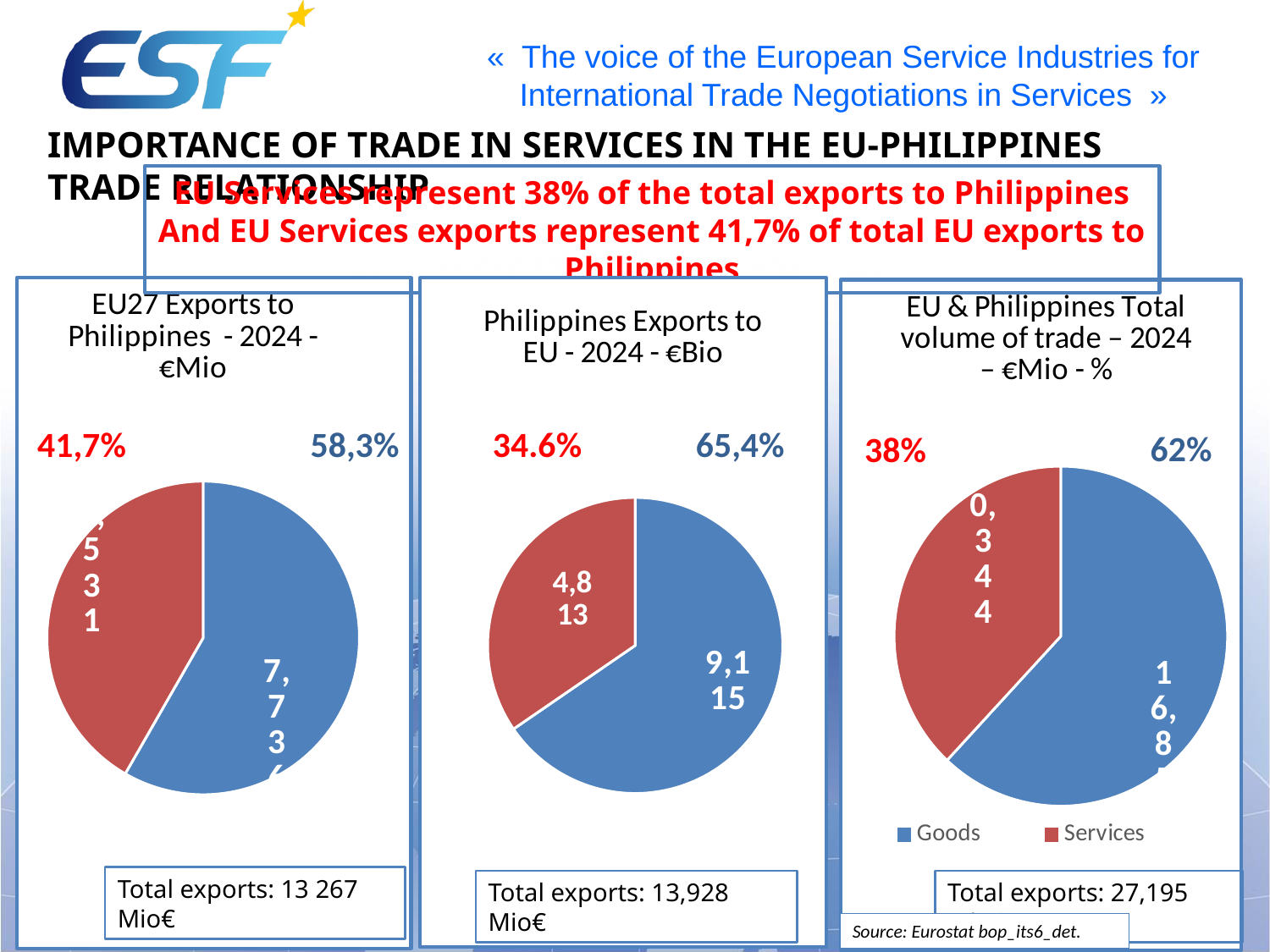
What total exports figure is given below the 'EU & Philippines Total volume of trade' chart? 27,195 In the 'EU & Philippines Total volume of trade' chart, what share of the pie is Goods? 62% How many entries does the legend of the 'EU & Philippines Total volume of trade' chart list? 2 In the 'EU & Philippines Total volume of trade' chart, what share of the pie is Services? 38% In the 'EU27 Exports to Philippines - 2024' chart, what percentage is shown for the red slice? 41,7% In the 'Philippines Exports to EU - 2024' chart, what is the value of the blue slice? 9,115 In the 'EU27 Exports to Philippines - 2024' chart, which slice is larger, the blue one or the red one? The blue one In the 'Philippines Exports to EU - 2024' chart, what is the value of the red slice? 4,813 In the 'EU & Philippines Total volume of trade' chart, which slice is larger, Goods or Services? Goods How many pie charts are shown on the slide? 3 What kind of chart is used on this slide? Pie chart